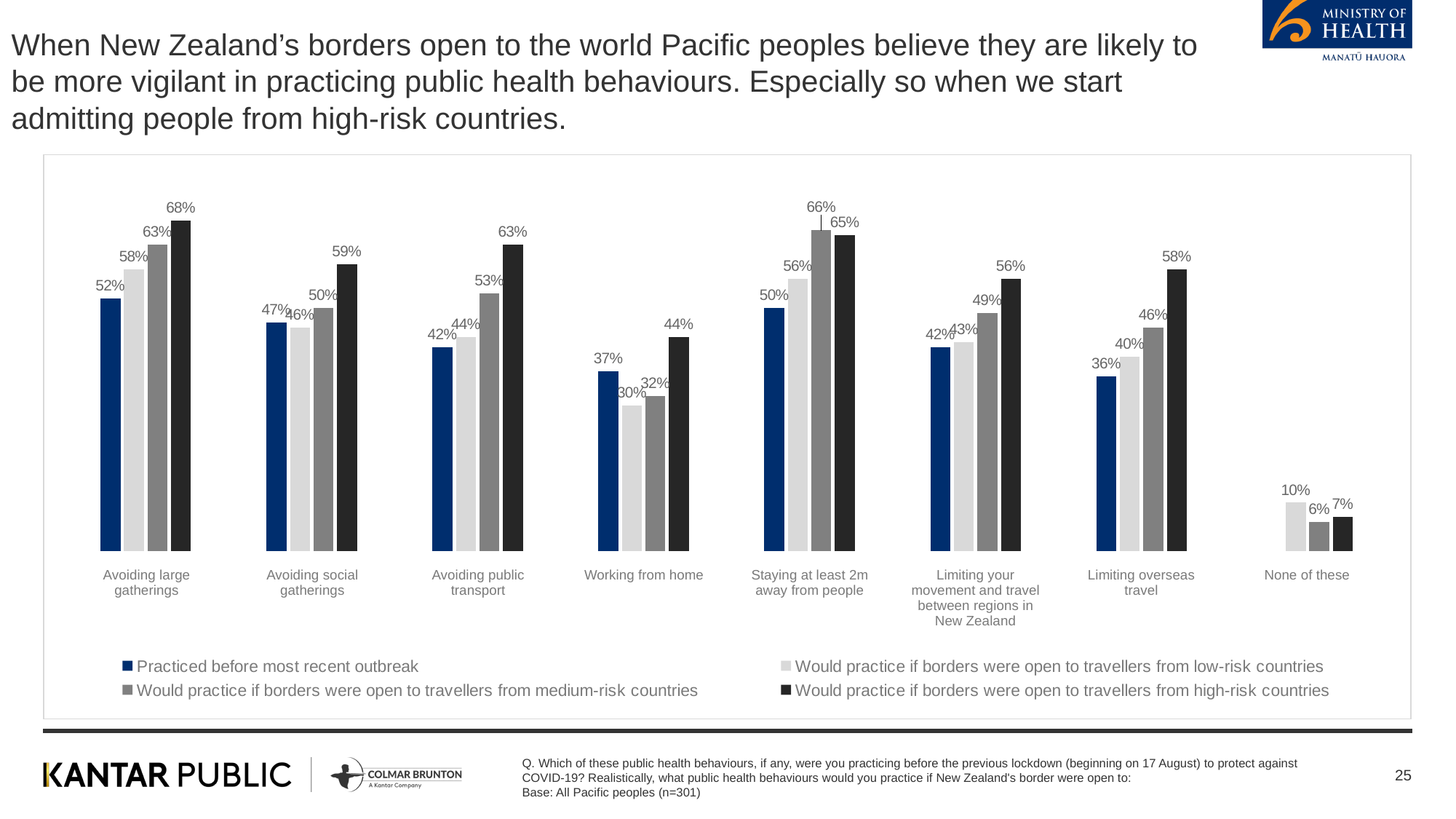
For 'Staying at least 2m away from people', which is larger: the medium-risk countries value or the high-risk countries value? Medium-risk countries (66%) Which category has the lowest value in the 'Would practice if borders were open to travellers from low-risk countries' series? None of these What kind of chart is shown on the slide? Bar chart Which category has the highest value in the 'Would practice if borders were open to travellers from high-risk countries' series? Avoiding large gatherings What is the value for 'Limiting overseas travel' in the 'Would practice if borders were open to travellers from medium-risk countries' series? 46% For 'Avoiding public transport', what is the difference between the high-risk countries value and the 'Practiced before most recent outbreak' value? 21 percentage points What is the value for 'Working from home' in the 'Would practice if borders were open to travellers from high-risk countries' series? 44% How many series does the legend list? 4 For 'Working from home', what is the difference between the 'Practiced before most recent outbreak' value and the low-risk countries value? 7 percentage points What percentage of Pacific peoples practiced avoiding large gatherings before the most recent outbreak? 52% Which series is shown in dark blue in the legend? Practiced before most recent outbreak How many categories are shown on the x axis of the chart? 8